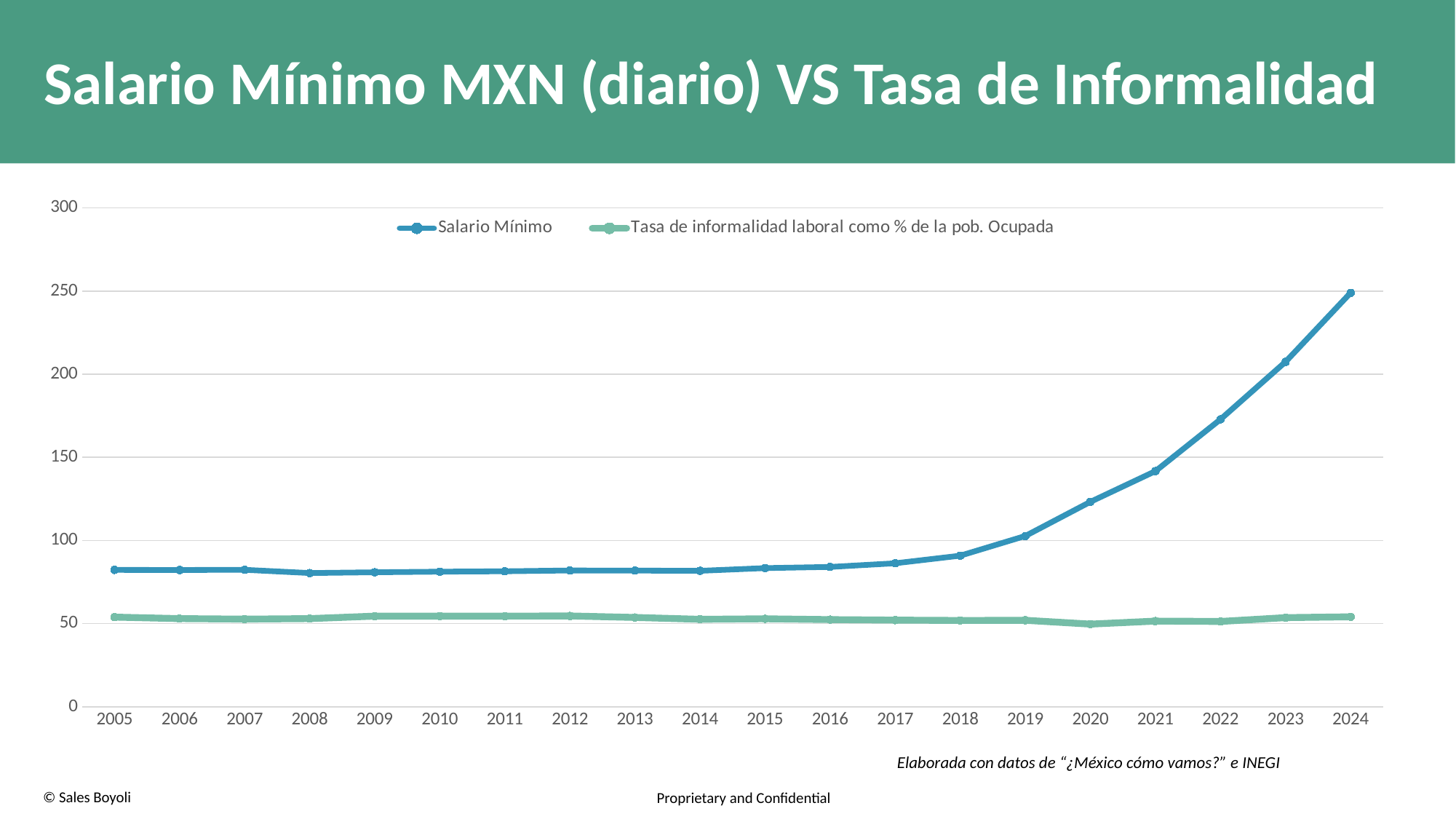
Is the Salario Mínimo value for 2020 greater or less than 100? greater Is the Salario Mínimo value for 2022 greater or less than 150? greater What is the title of the chart on the slide? Salario Mínimo MXN (diario) VS Tasa de Informalidad Is the Salario Mínimo value for 2024 greater or less than 200? greater In which year is the Salario Mínimo series at its highest? 2024 How many series does the legend list? 2 How many years are plotted along the x axis? 20 Does the Salario Mínimo series rise or fall from 2018 to 2024? rise Which series has the larger value in 2024, Salario Mínimo or Tasa de informalidad laboral? Salario Mínimo What kind of chart is shown on the slide? line chart